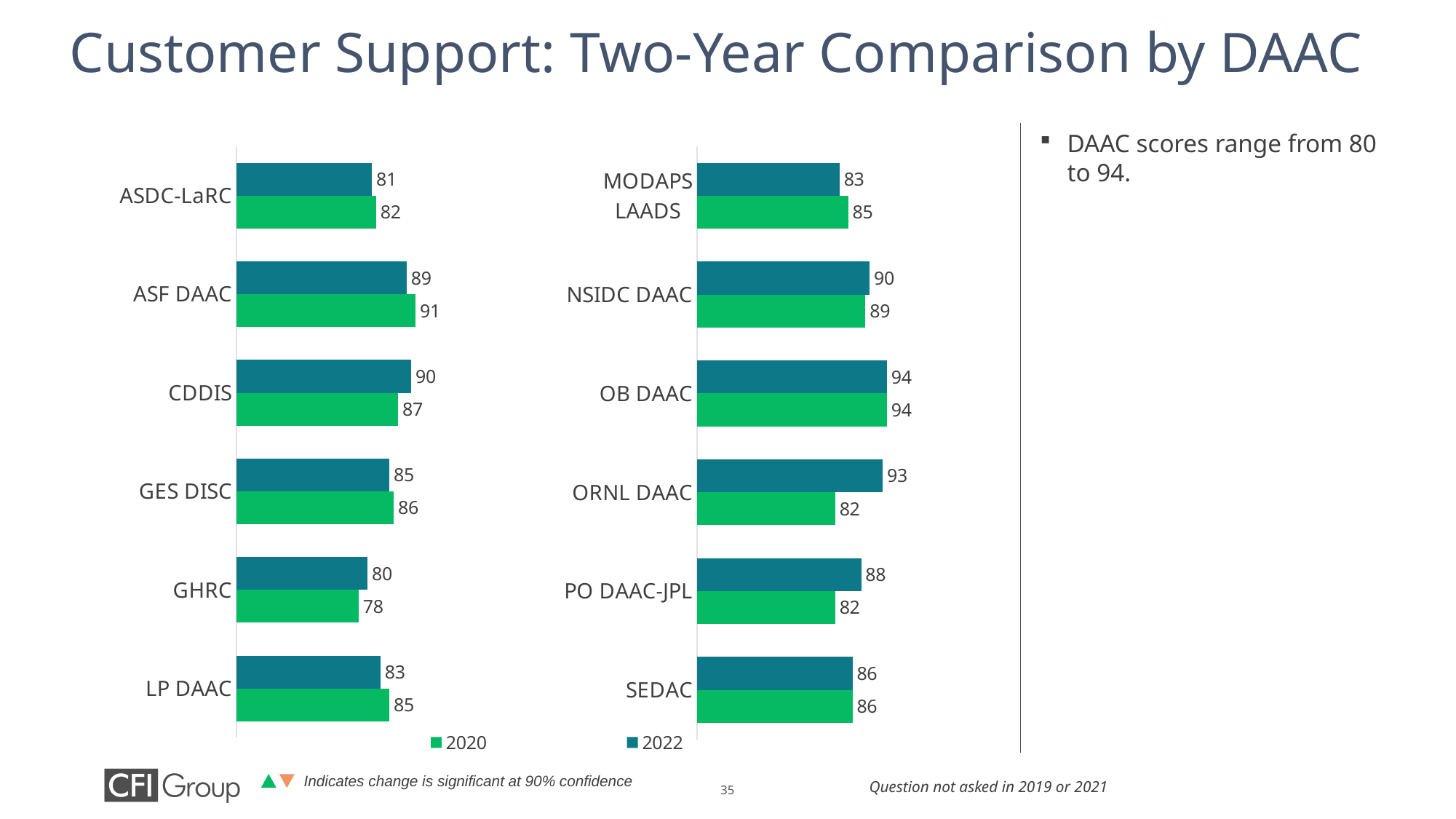
In the right chart, what is the 2020 score for ORNL DAAC? 82 Which colour represents the 2020 series in the legend? green In the right chart, which DAAC has the highest 2022 score? OB DAAC In the left chart, what is the difference between the 2020 and 2022 scores for ASF DAAC? 2 In the right chart, what is the difference between the 2022 and 2020 scores for ORNL DAAC? 11 In the right chart, is the 2022 score for PO DAAC-JPL higher or lower than its 2020 score? higher How many series does the legend list? 2 In the left chart, what is the 2022 Customer Support score for CDDIS? 90 How many DAACs are shown in the left chart? 6 What type of chart is used on this slide? bar chart In the left chart, which DAAC has the lowest 2022 score? GHRC In the left chart, what is the 2020 score for GHRC? 78